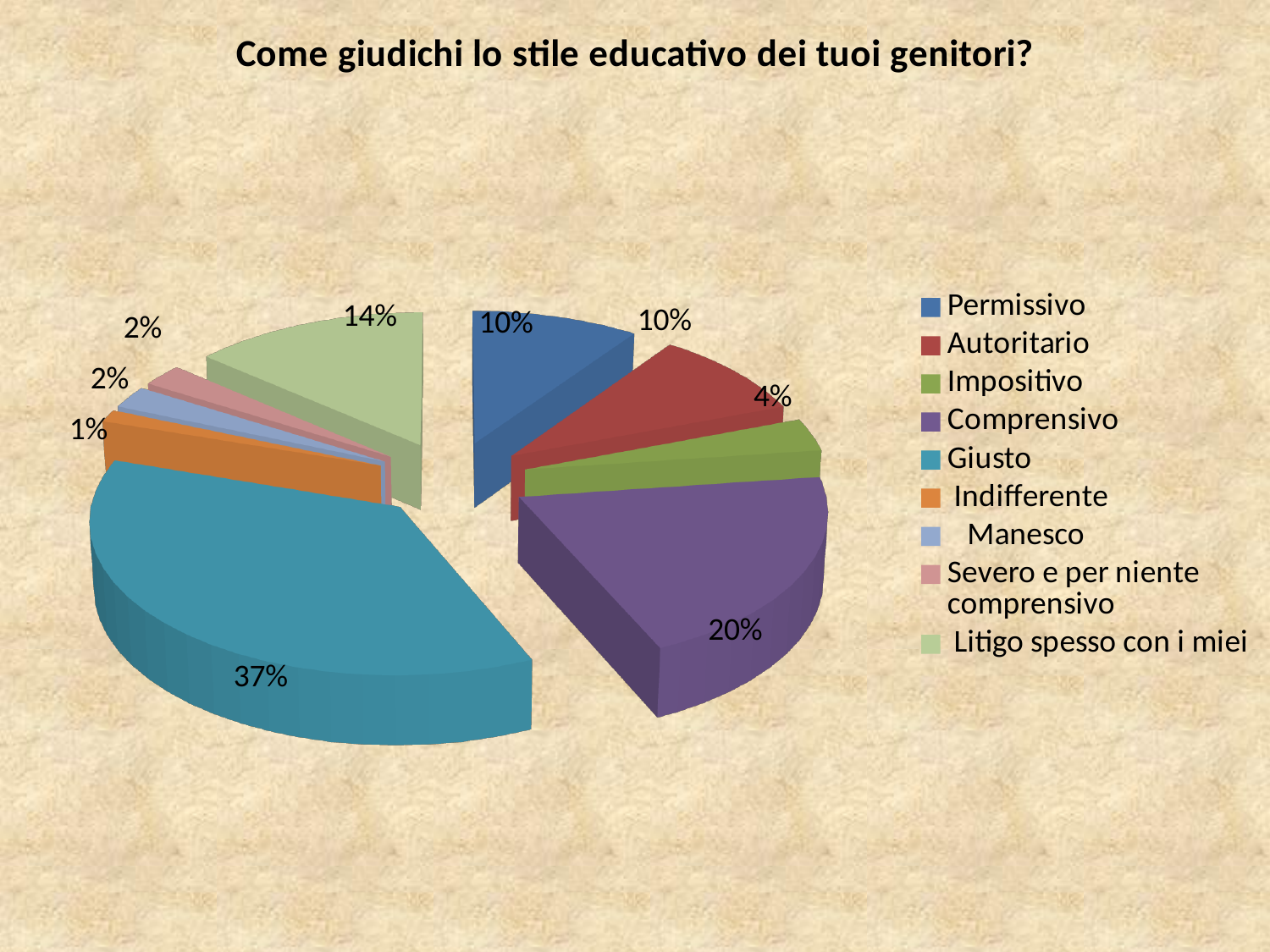
Which is larger, the slice for Comprensivo or the slice for Litigo spesso con i miei? Comprensivo What kind of chart is shown on the slide? Pie chart Which category has the smallest slice of the pie? Indifferente What percentage is shown for Litigo spesso con i miei? 14% What is the difference in percentage points between Giusto and Comprensivo? 17 What colour is the slice for Autoritario? Red Which category has the largest slice of the pie? Giusto What percentage is shown for Impositivo? 4% How many categories does the legend list? 9 What percentage of the pie is labelled for Giusto? 37% What is the title of the chart? Come giudichi lo stile educativo dei tuoi genitori? What percentage is shown for Comprensivo? 20%